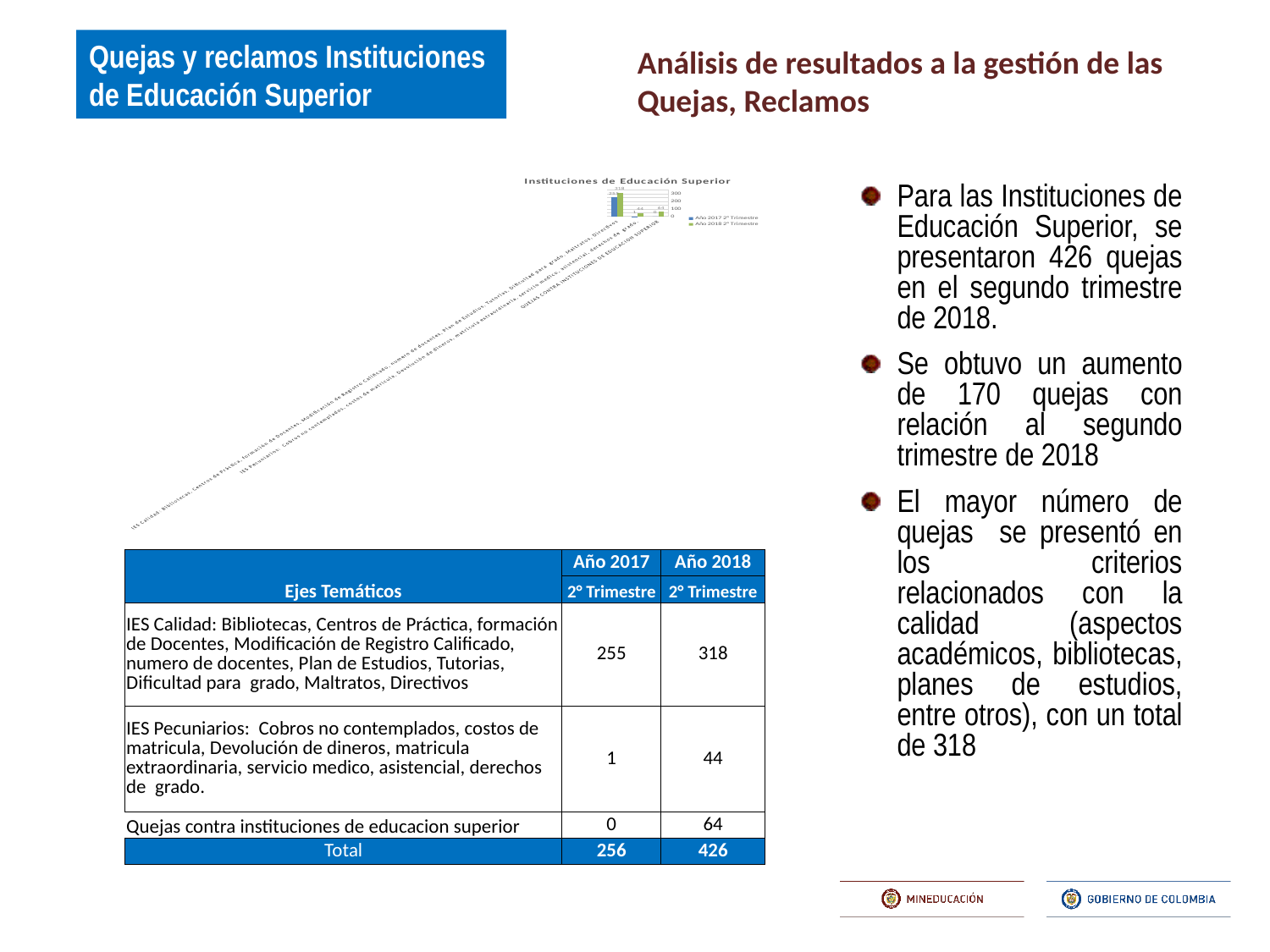
What is the Año 2018 2° Trimestre value for the IES Pecuniarios category? 44 What is the highest value labelled on the chart? 318 How many categories are plotted on the chart's x axis? 3 What is the Año 2017 2° Trimestre value for the IES Calidad category? 255 What is the lowest value labelled on the chart? 0 Is the Año 2018 2° Trimestre value for the IES Calidad category greater or less than 300? greater What is the title of the chart? Instituciones de Educación Superior What kind of chart is shown on the slide? bar chart For the IES Calidad category, which series has the larger value, Año 2017 2° Trimestre or Año 2018 2° Trimestre? Año 2018 2° Trimestre What are the two legend entries of the chart? Año 2017 2° Trimestre and Año 2018 2° Trimestre What is the difference between the Año 2018 and Año 2017 values for the IES Calidad category? 63 How many series does the chart's legend list? 2